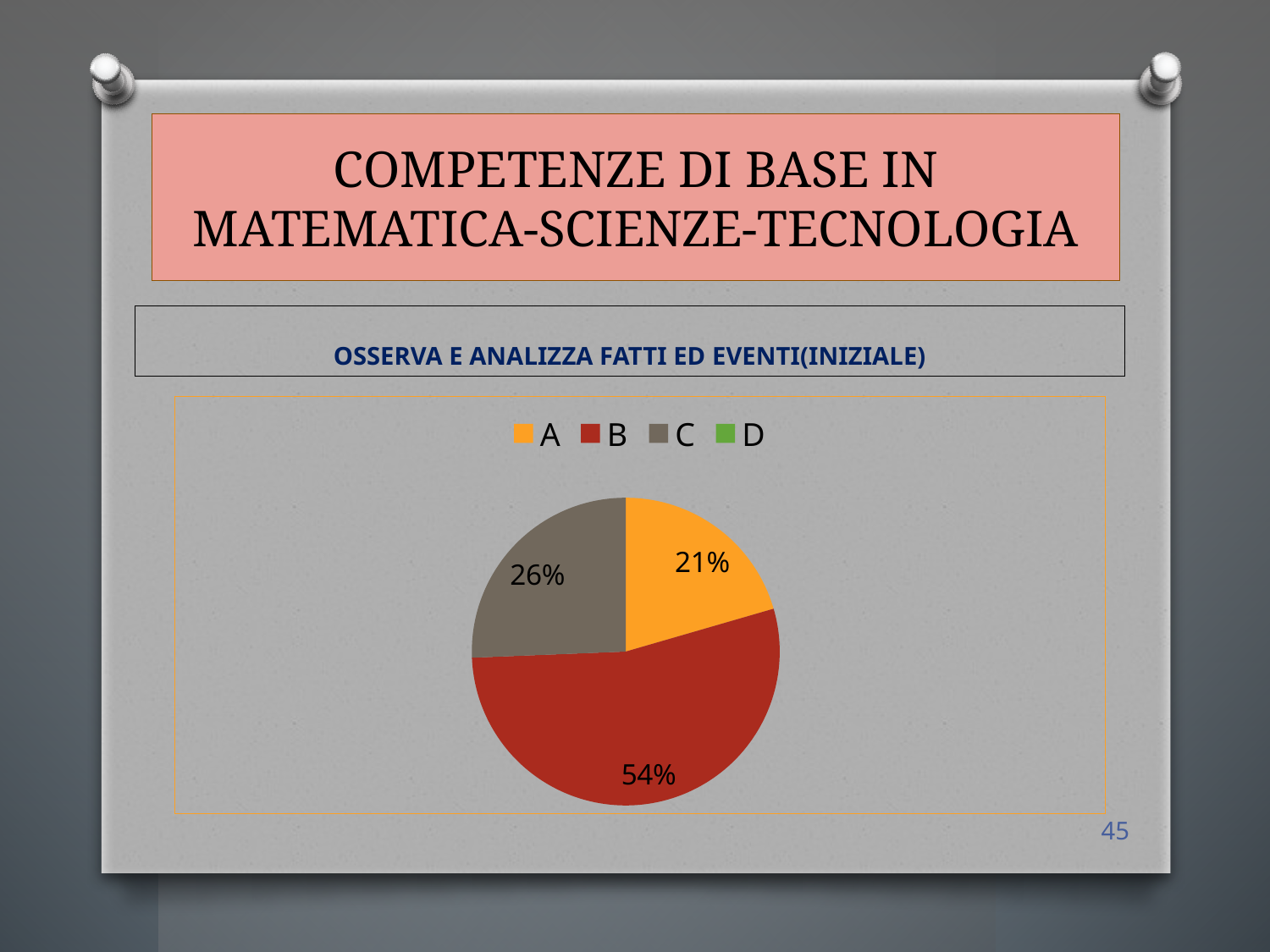
What is the difference in percentage points between slice B and slice A? 33 What percentage does slice C represent in the pie chart? 26% Which category has the largest slice in the pie chart? B Which is larger, the share for B or the share for C? B How many entries does the legend of the pie chart list? 4 What is the difference in percentage points between slice C and slice A? 5 What type of chart is shown on the slide? pie chart What colour is the slice for category B in the pie chart? red What percentage does slice A represent in the pie chart? 21% What is the text in the box directly above the pie chart? OSSERVA E ANALIZZA FATTI ED EVENTI(INIZIALE) What percentage does slice B represent in the pie chart? 54% Among the slices with printed labels, which category has the smallest share? A